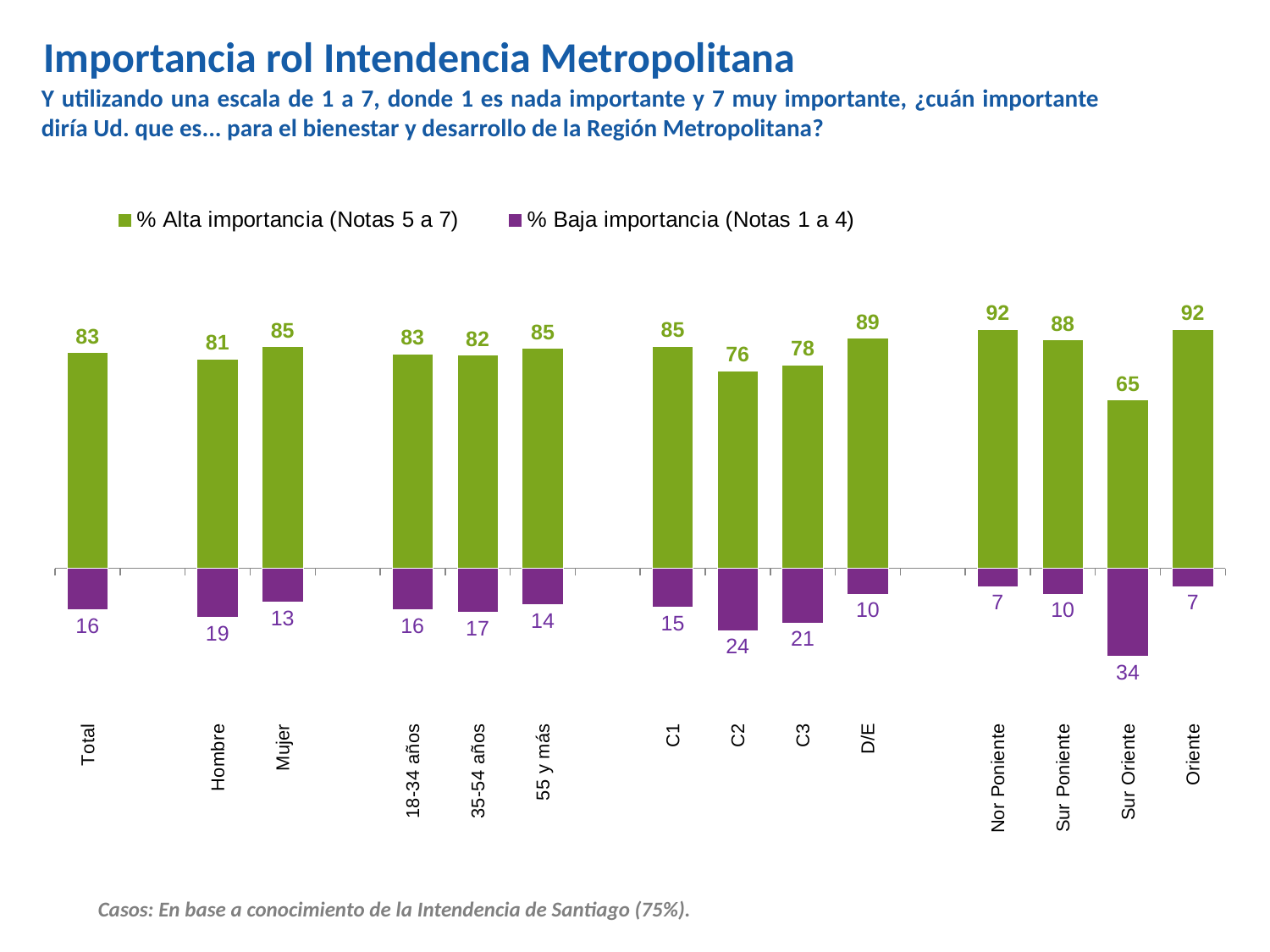
What is the % Alta importancia value for Sur Oriente? 65 What is the % Baja importancia value for Nor Poniente? 7 What is the % Baja importancia value for C2? 24 What kind of chart is shown on the slide? Bar chart Which category has the highest % Baja importancia value? Sur Oriente What colour are the % Baja importancia bars? Purple What is the difference between the % Alta importancia values for Mujer and Hombre? 4 Which category has the lowest % Alta importancia value? Sur Oriente Which has a higher % Alta importancia value, C1 or C2? C1 How many series does the legend list? 2 How many categories are shown on the x axis? 14 What is the % Alta importancia value for Total? 83